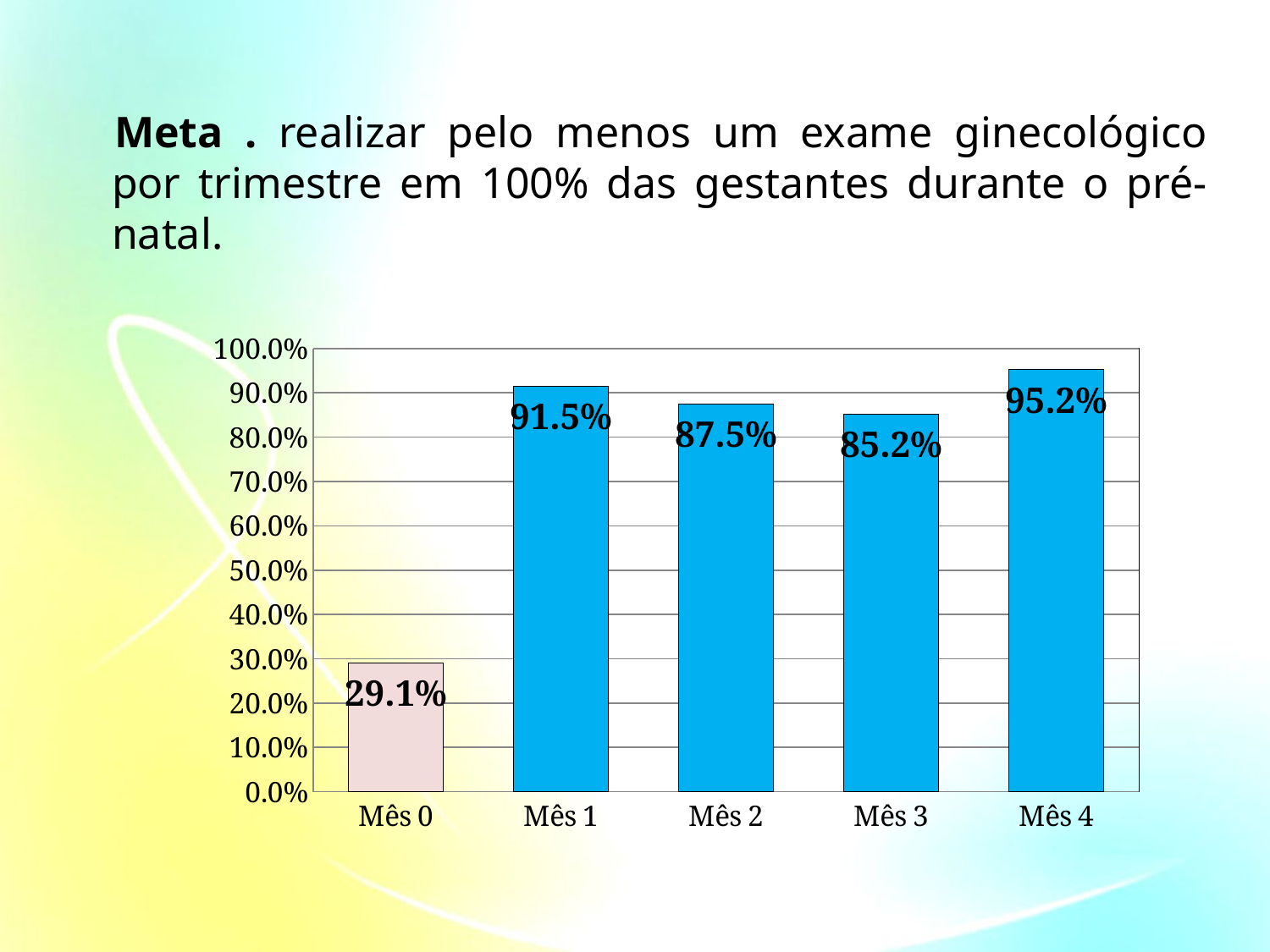
What is the difference between the values for Mês 1 and Mês 3? 6.3% Which category has the lowest value? Mês 0 What is the value for Mês 4? 95.2% What is the value for Mês 2? 87.5% What kind of chart is shown on the slide? bar chart What is the difference between the values for Mês 4 and Mês 0? 66.1% How many categories are shown on the x axis? 5 Which bar is shown in a different colour from the others? Mês 0 Which category has the highest value? Mês 4 Is the value for Mês 3 greater or less than 80.0%? greater Which is larger, the value for Mês 1 or the value for Mês 2? Mês 1 What is the value for Mês 0? 29.1%